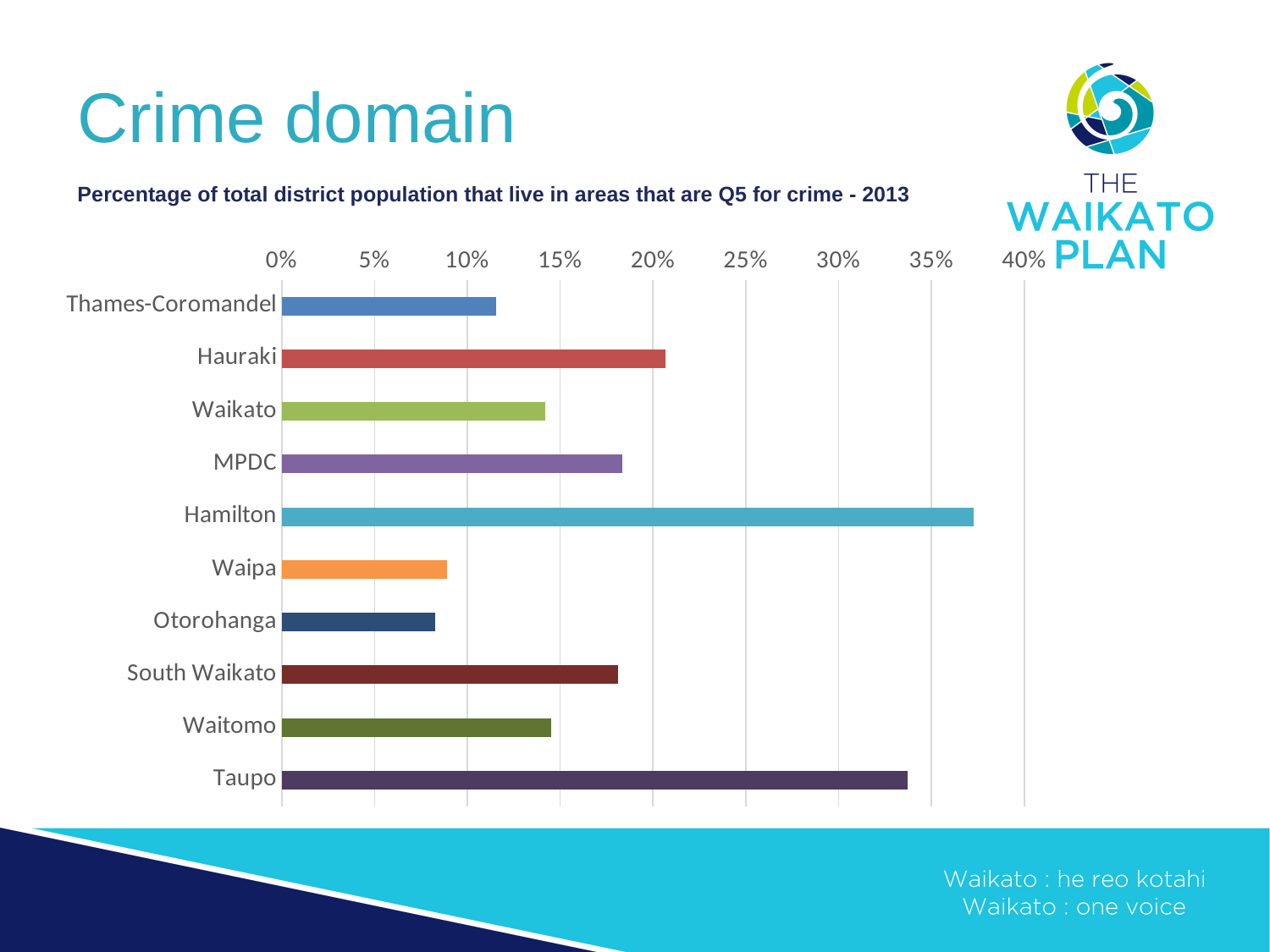
Which has a higher value, Hamilton or Taupo? Hamilton Is the value for Waipa greater or less than 10%? less Which has a higher value, Hauraki or Thames-Coromandel? Hauraki Is the value for Otorohanga greater or less than 10%? less Is the value for Thames-Coromandel greater or less than 15%? less What year does the chart's data refer to, according to its title? 2013 What kind of chart is shown on the slide? Bar chart Which district has the highest percentage of its population living in areas that are Q5 for crime? Hamilton How many districts are shown on the chart? 10